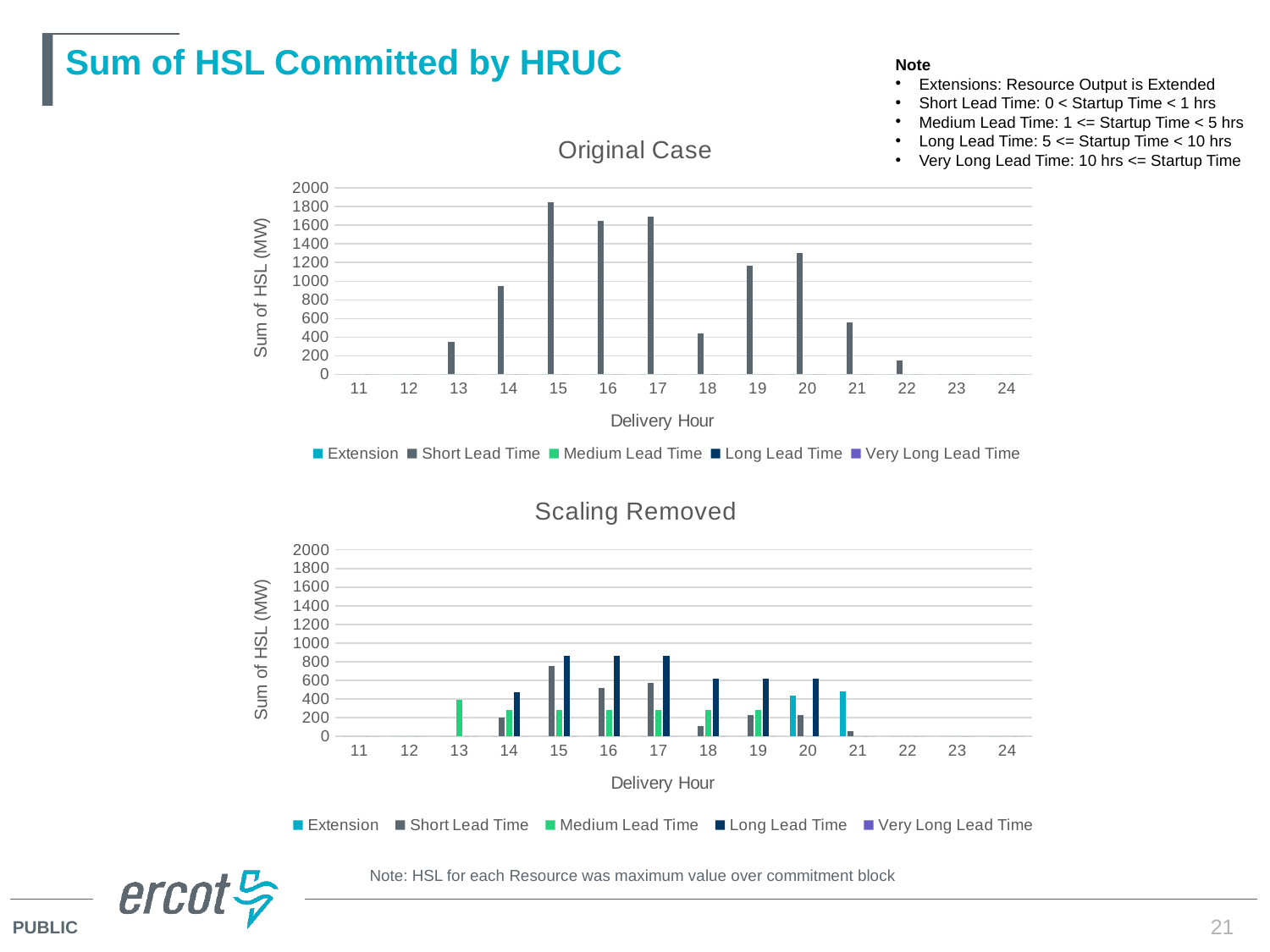
In the Scaling Removed chart, is the Long Lead Time value for delivery hour 18 greater or less than 400? greater In the Original Case chart, which is larger, the value for delivery hour 19 or delivery hour 20? delivery hour 20 In the Scaling Removed chart, is the Short Lead Time value for delivery hour 15 greater or less than 600? greater What is the title of the lower chart on the slide? Scaling Removed In the Scaling Removed chart, is the Long Lead Time value for delivery hour 15 greater or less than 800? greater In the Original Case chart, how many delivery hours are shown on the x axis? 14 In the Original Case chart, which delivery hour has the highest Sum of HSL? 15 In the Scaling Removed chart, which series has the tallest bar at delivery hour 16? Long Lead Time In the Original Case chart, how many series does the legend list? 5 In the Original Case chart, what kind of chart is shown? bar chart